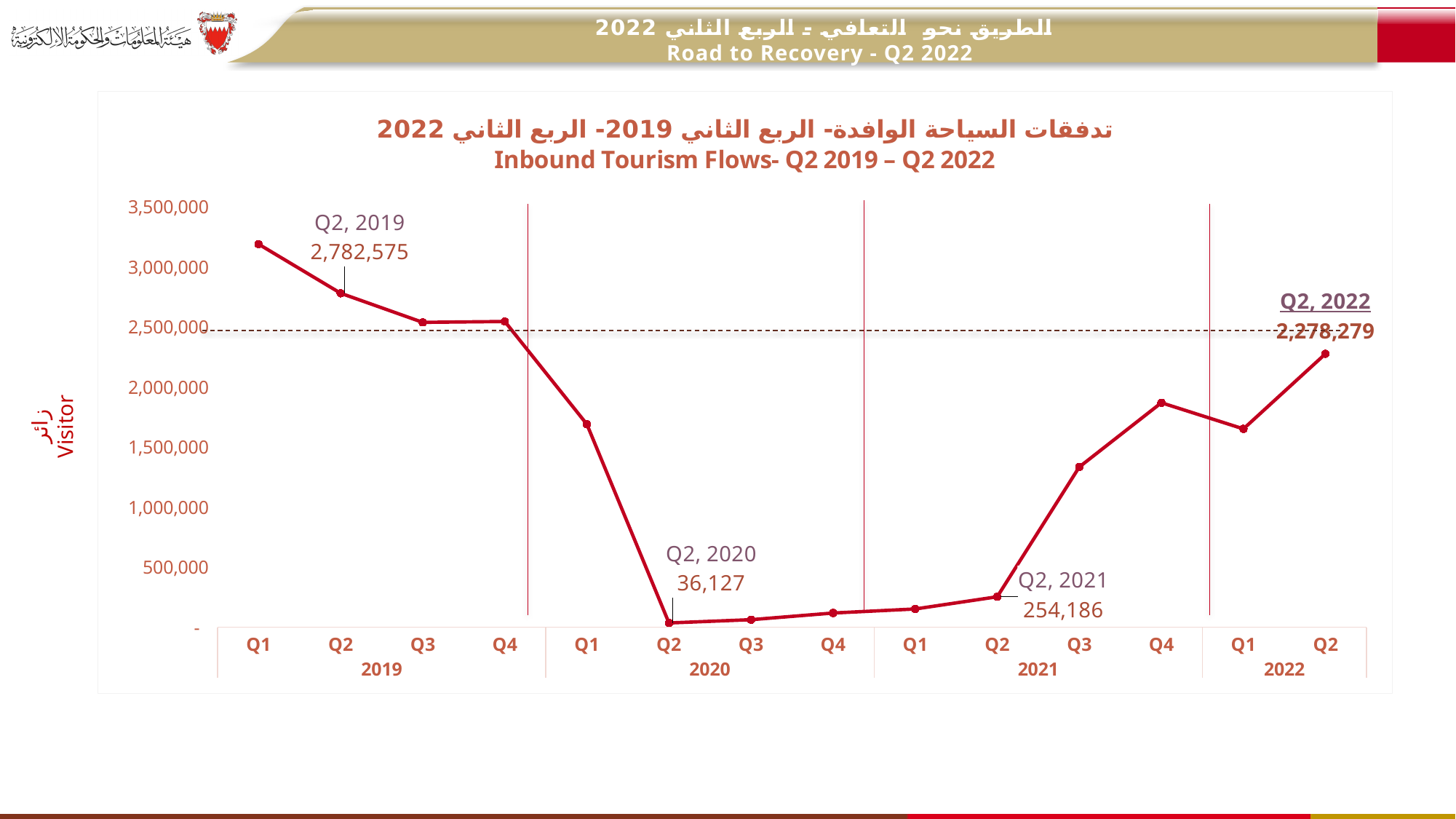
What is the value for Q2 2019 in the Inbound Tourism Flows chart? 2,782,575 What is the value for Q2 2020 in the Inbound Tourism Flows chart? 36,127 Is the value for Q1 2022 greater or less than 2,000,000? less How many quarterly data points are plotted in the Inbound Tourism Flows chart? 14 What is the difference between the Q2 2022 value and the Q2 2021 value? 2,024,093 What is the value for Q2 2021 in the Inbound Tourism Flows chart? 254,186 What is the value for Q2 2022 in the Inbound Tourism Flows chart? 2,278,279 By how much is the Q2 2019 value higher than the Q2 2022 value? 504,296 What kind of chart is used to show Inbound Tourism Flows? line chart Which quarter has the lowest value in the Inbound Tourism Flows chart? Q2 2020 Is the value for Q1 2019 greater or less than 3,000,000? greater Which quarter has the highest value in the Inbound Tourism Flows chart? Q1 2019